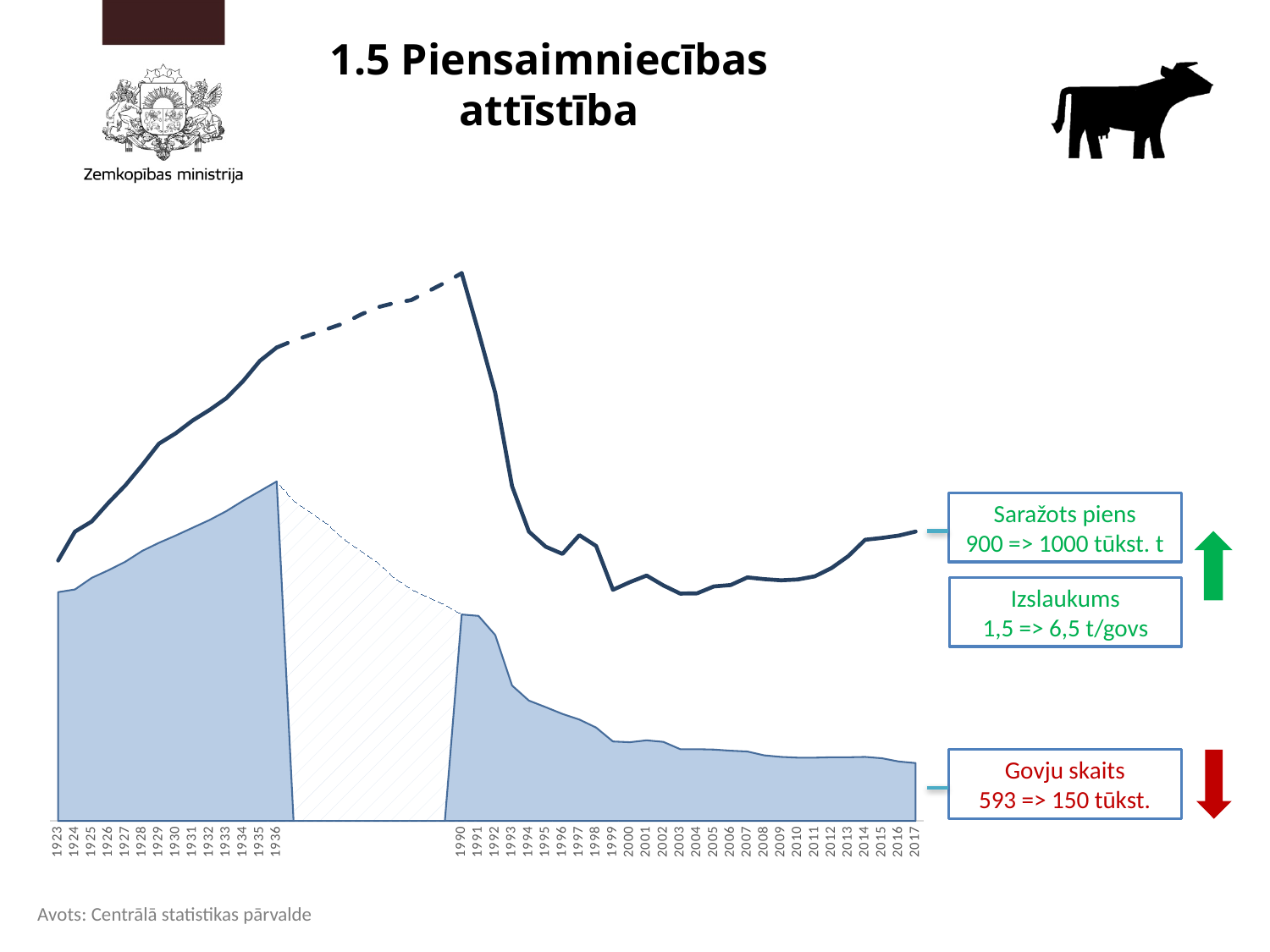
What is the last year shown on the x axis? 2017 Does the number of cows (Govju skaits) rise or fall from 1990 to 2017? fall What is the title of the chart slide? 1.5 Piensaimniecības attīstība According to the annotation, what was the number of cows (Govju skaits) at the start and end of the period? 593 => 150 tūkst. According to the annotation, how did milk yield per cow (Izslaukums) change over the period? 1,5 => 6,5 t/govs Does the milk production line (Saražots piens) rise or fall from 1923 to 1936? rise How many years are labelled on the x axis in the first segment, from 1923 to 1936? 14 According to the annotation, how did milk production (Saražots piens) change over the period? 900 => 1000 tūkst. t What kind of chart is used to show the number of cows (Govju skaits)? area chart What is the first year shown on the x axis? 1923 What kind of chart is used to show milk produced (Saražots piens)? line chart Does the milk production line (Saražots piens) rise or fall from 1990 to 1999? fall